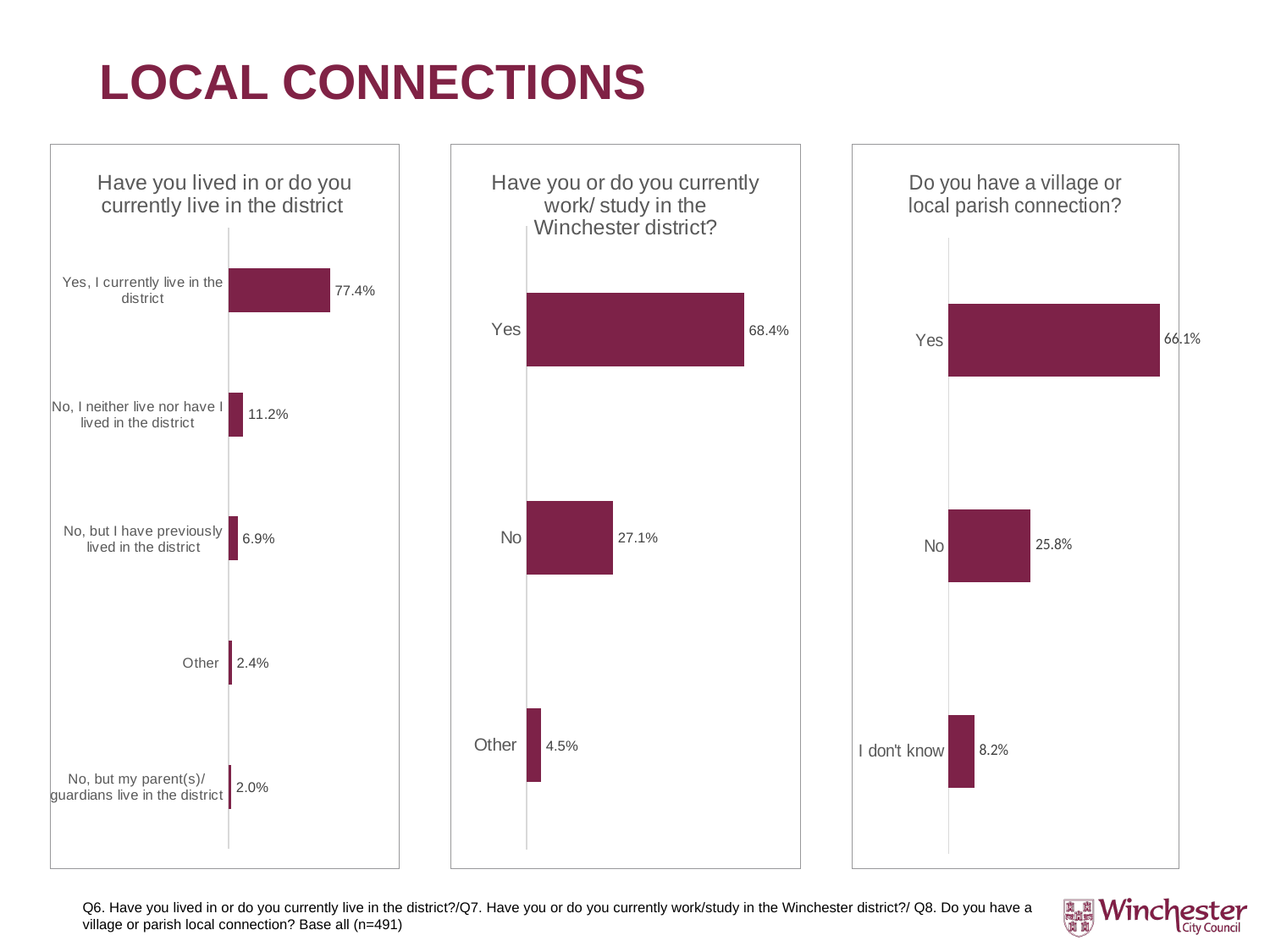
In the chart 'Do you have a village or local parish connection?', what is the value for 'I don't know'? 8.2% In the chart 'Do you have a village or local parish connection?', which is larger, 'No' or 'I don't know'? No How many charts are shown on the slide? 3 In the chart 'Do you have a village or local parish connection?', how many categories are shown? 3 What type of chart is the middle chart on the slide? Bar chart In the chart 'Have you lived in or do you currently live in the district', what is the value for 'Yes, I currently live in the district'? 77.4% In the chart 'Have you lived in or do you currently live in the district', what is the difference between 'No, I neither live nor have I lived in the district' and 'No, but I have previously lived in the district'? 4.3% In the chart 'Have you lived in or do you currently live in the district', which category has the lowest value? No, but my parent(s)/ guardians live in the district In the chart 'Have you lived in or do you currently live in the district', how many categories are shown? 5 In the chart 'Have you or do you currently work/ study in the Winchester district?', what is the value for 'No'? 27.1% In the chart 'Have you or do you currently work/ study in the Winchester district?', what is the difference between 'Yes' and 'No'? 41.3% In the chart 'Have you or do you currently work/ study in the Winchester district?', which category has the highest value? Yes